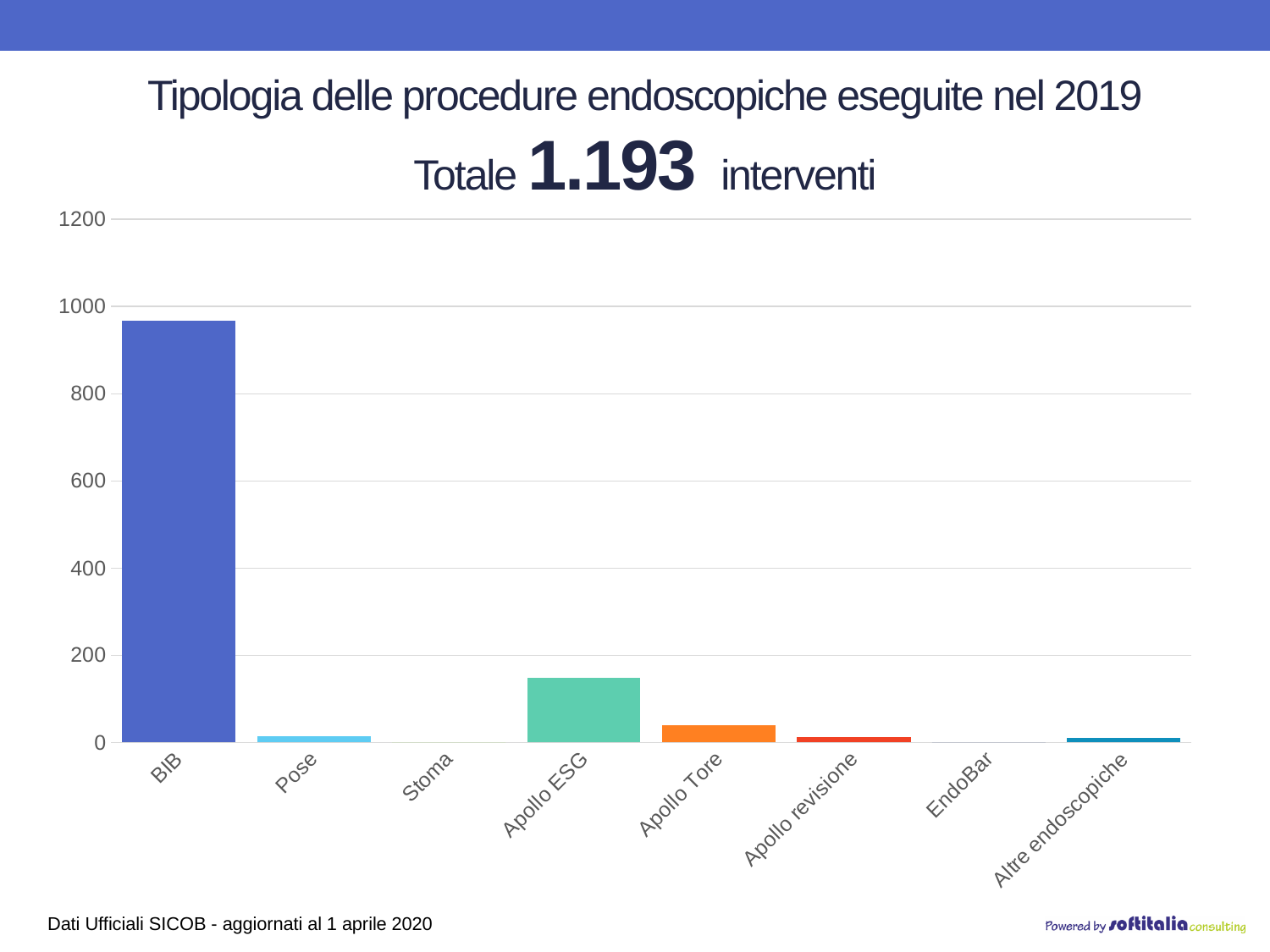
According to the slide title, what is the total number of interventi? 1.193 What is the title of the chart? Tipologia delle procedure endoscopiche eseguite nel 2019 Is the value for BIB greater or less than 1000? less Is the value for Apollo ESG greater or less than 200? less Which category has the highest value? BIB How many procedure categories are shown on the x axis? 8 Is the value for Apollo ESG greater or less than 100? greater Which is larger, the value for Apollo Tore or the value for Pose? Apollo Tore Which is larger, the value for Apollo ESG or the value for Apollo Tore? Apollo ESG What kind of chart is shown on the slide? bar chart